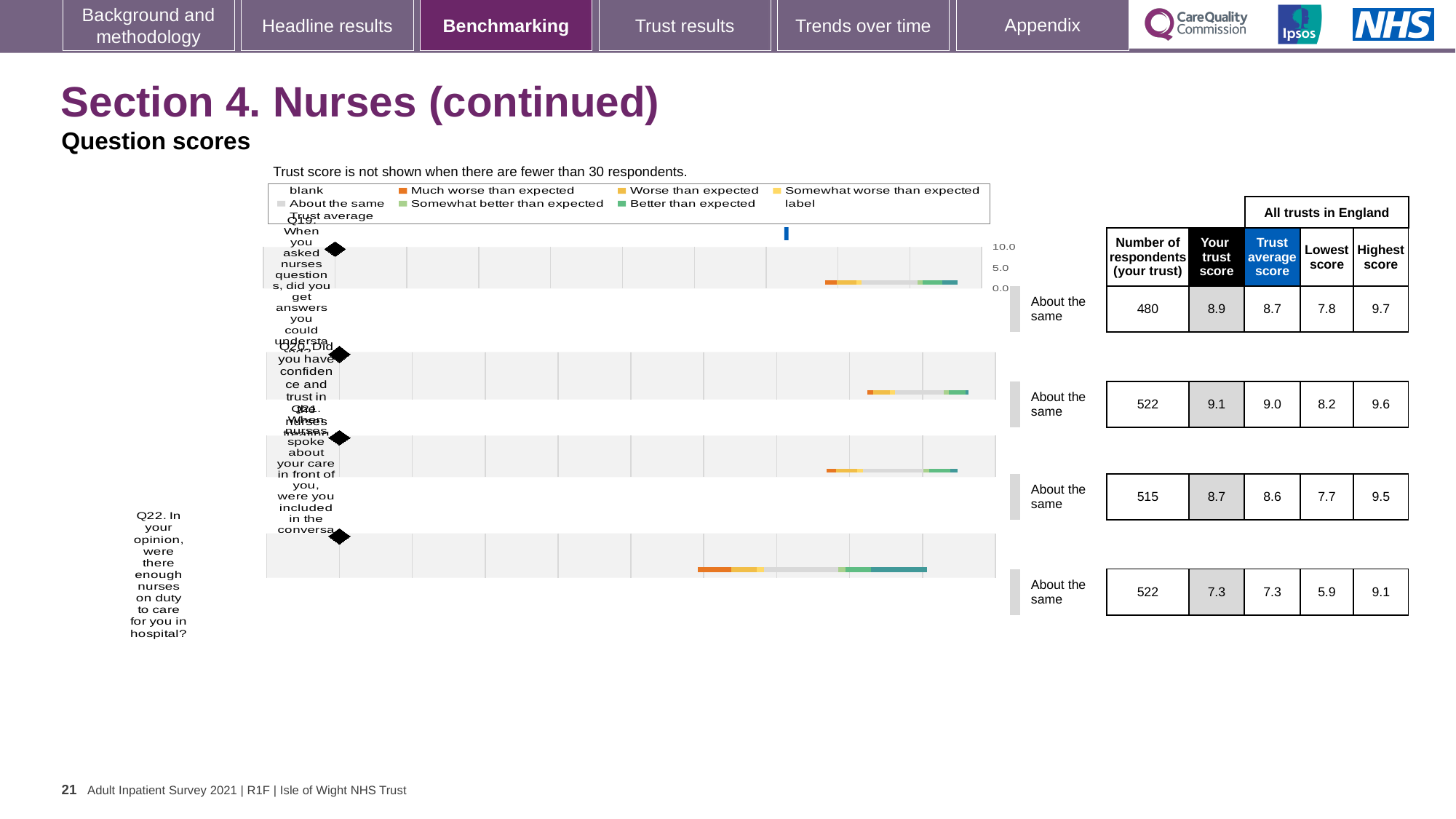
What is the trust score for Q22 (enough nurses on duty)? 7.3 How many questions are shown on the chart? 4 What benchmark category is shown for Q21? About the same Is the trust score for Q19 higher or lower than the trust average score for Q19? higher What is the highest score in England for Q21? 9.5 What kind of chart is used to show the question scores? bar chart What is the trust average score across all trusts in England for Q20? 9.0 Which question has the highest trust score for this trust? Q20 What is the difference between the highest and lowest scores in England for Q22? 3.2 How many respondents answered Q19 for this trust? 480 Which question has the lowest trust score for this trust? Q22 What is the lowest score in England for Q22? 5.9